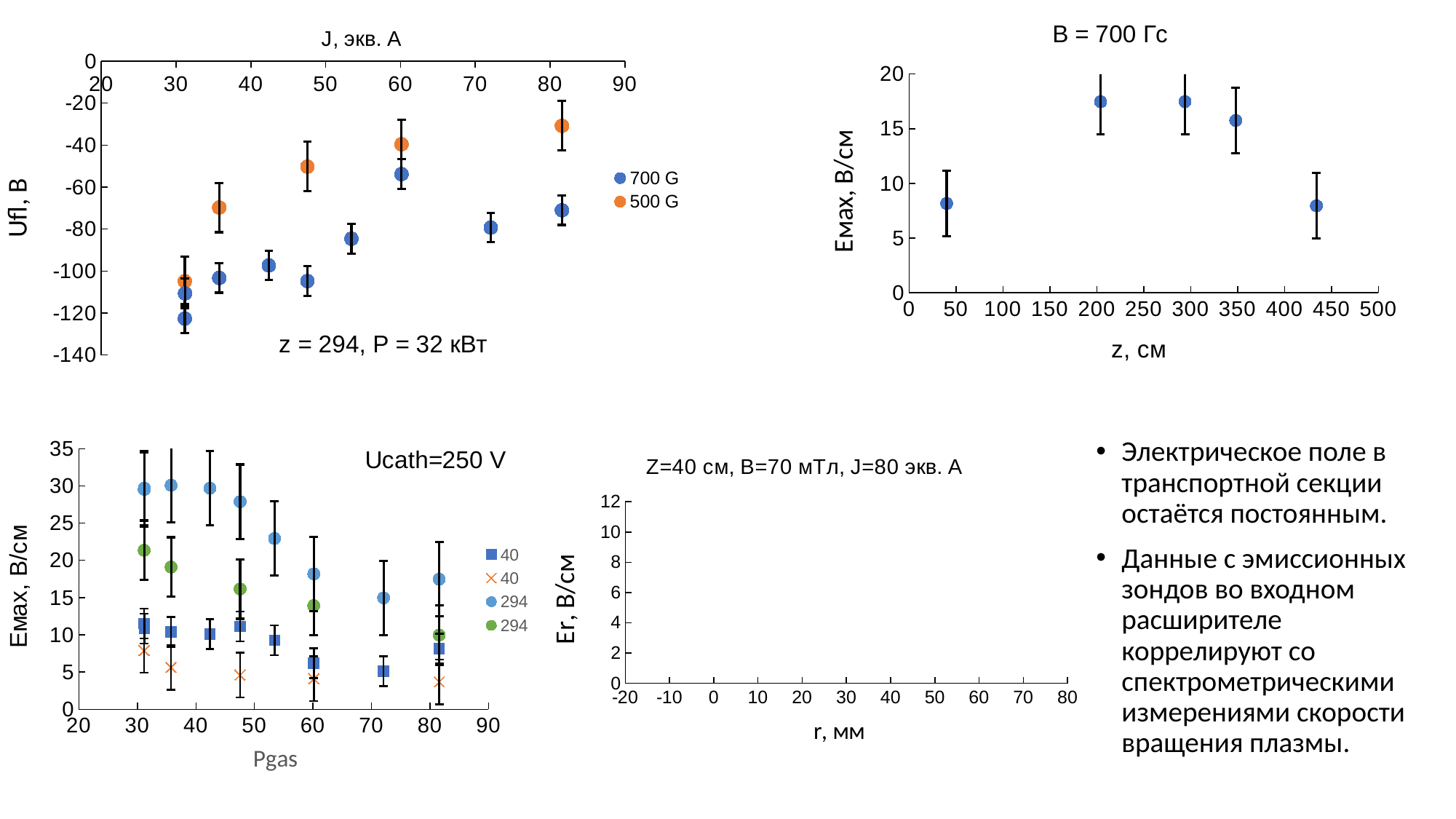
In the bottom-left chart (Ucath=250 V), is the light-blue circle (294) value at Pgas of about 31 greater or less than 25? greater In the bottom-left chart (Ucath=250 V), do the light-blue circle (294) values rise or fall as Pgas increases? fall What kind of chart is the top-right chart titled 'B = 700 Гс'? scatter chart In the top-right chart titled 'B = 700 Гс', is the Emax value at z of about 200 cm greater or less than 15? greater In the top-left chart (Ufl vs J), how many points are plotted for the 500 G series? 5 In the top-left chart (Ufl vs J), do the 700 G values rise or fall as J increases? rise In the bottom-left chart (Ucath=250 V), how many series does the legend list? 4 In the top-left chart (Ufl vs J), how many series does the legend list? 2 In the top-right chart titled 'B = 700 Гс', how many data points are plotted? 5 In the top-right chart titled 'B = 700 Гс', is the Emax value at z of about 430 cm greater or less than 10? less In the top-left chart (Ufl vs J), at J of about 60, which series has the larger (less negative) Ufl value, 700 G or 500 G? 500 G In the top-left chart (Ufl vs J), what are the two legend entries? 700 G and 500 G